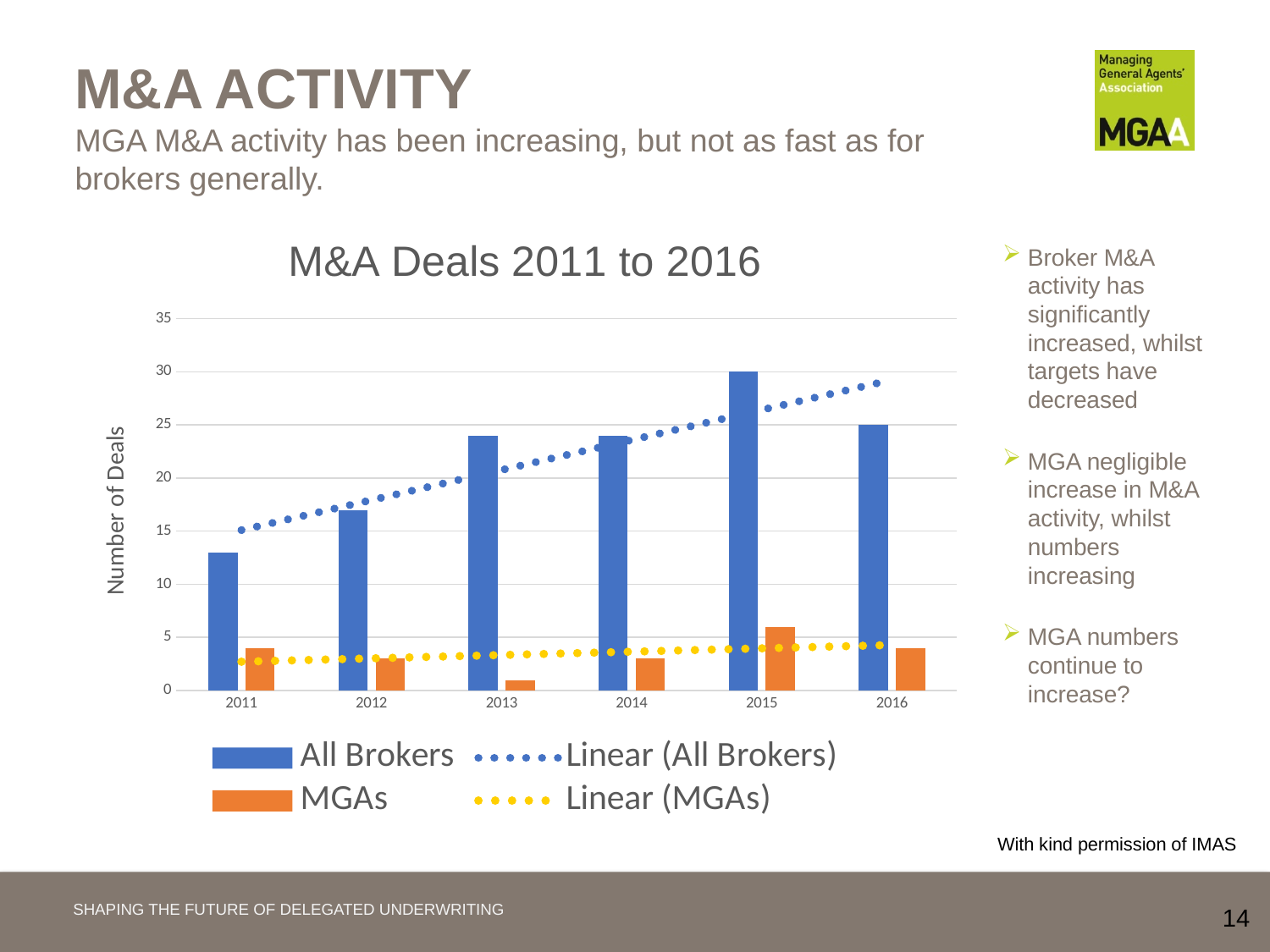
In which year is the All Brokers value lowest? 2011 In which year is the All Brokers value highest? 2015 Is the value for MGAs in 2015 greater or less than 5? greater What is the title of the chart? M&A Deals 2011 to 2016 In which year is the MGAs value lowest? 2013 How many entries does the chart legend list? 4 Is the value for All Brokers in 2011 greater or less than 15? less What is the value for All Brokers in 2015? 30 Which is larger, the All Brokers value in 2015 or in 2016? 2015 How many years are shown on the x axis of the chart? 6 What is the value for All Brokers in 2016? 25 What type of chart is shown on the slide? Bar chart